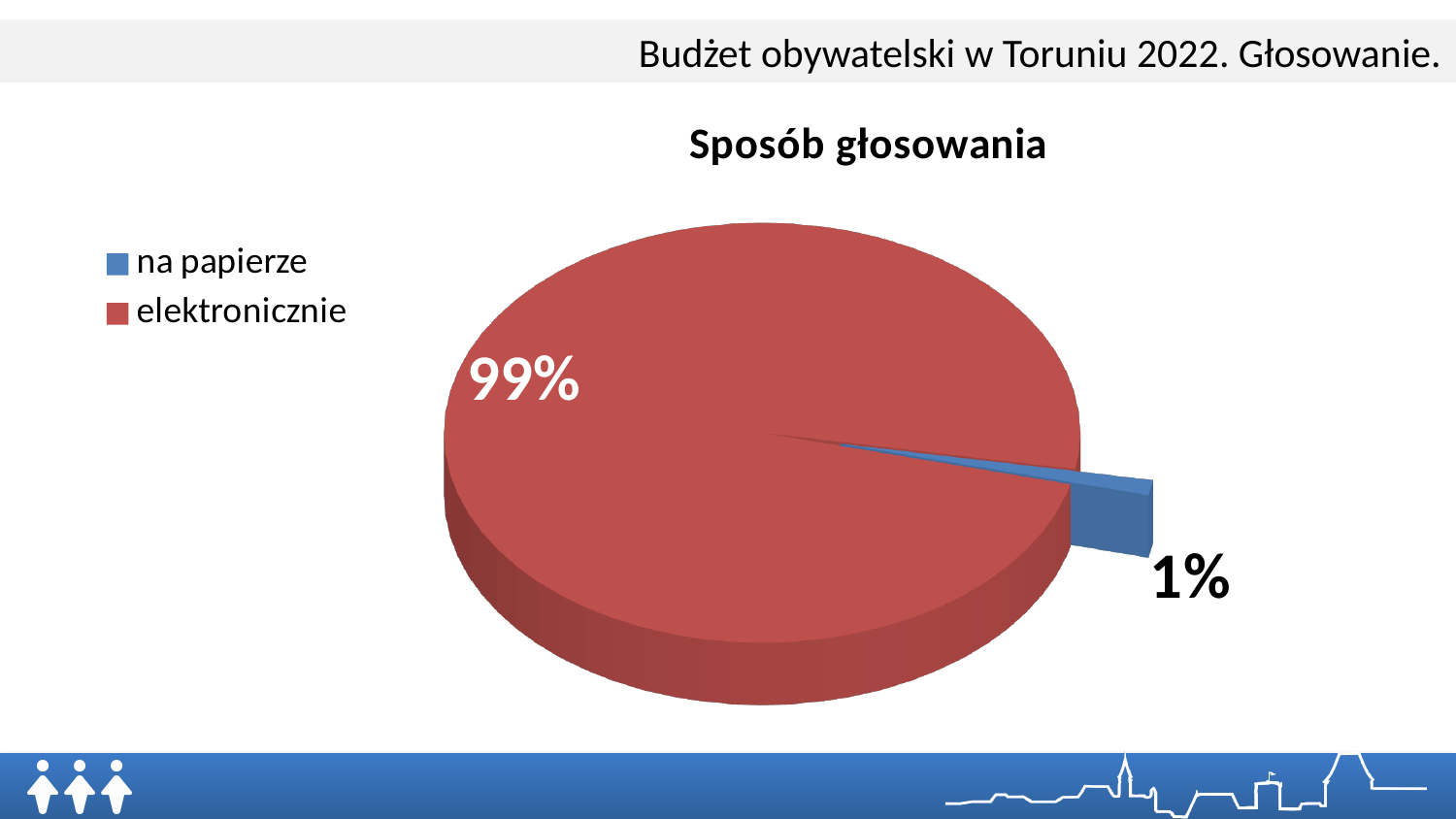
What colour is the slice for 'na papierze'? blue What is the difference in percentage points between 'elektronicznie' and 'na papierze'? 98 What share of the pie is labelled for 'na papierze'? 1% What is the title of the chart? Sposób głosowania Which category has the largest slice of the pie? elektronicznie How many entries does the legend list? 2 Which category has the smallest slice of the pie? na papierze What share of the pie is labelled for 'elektronicznie'? 99% What kind of chart is shown on the slide? pie chart How many categories does the pie chart show? 2 Which is larger, the share for 'na papierze' or the share for 'elektronicznie'? elektronicznie